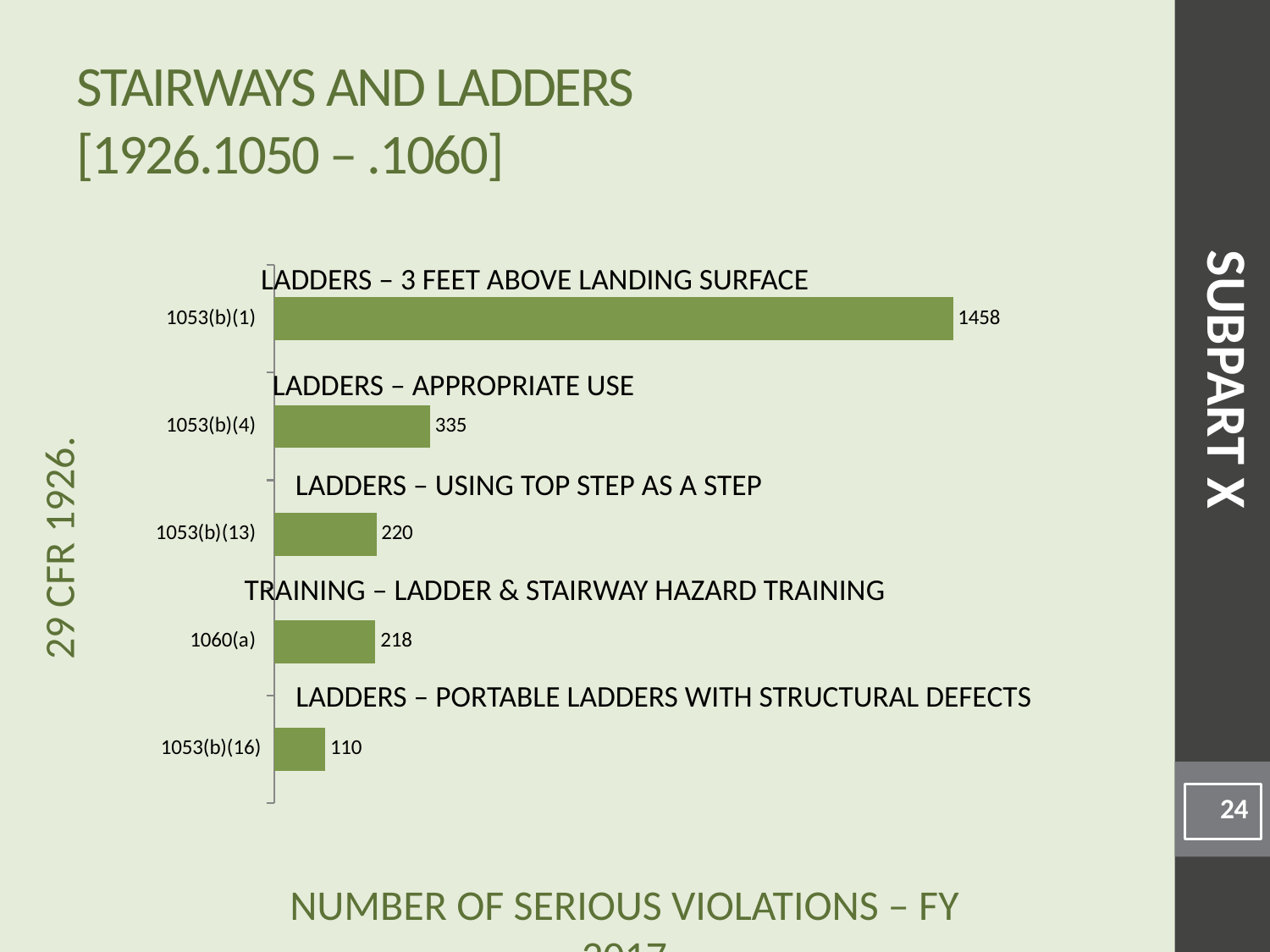
Which category has the lowest number of serious violations? 1053(b)(16) What kind of chart is shown on the slide? Bar chart What is the difference between the values for 1053(b)(1) and 1053(b)(4)? 1123 What is the number of serious violations for 1053(b)(4)? 335 What is the number of serious violations for 1060(a)? 218 Which category has the highest number of serious violations? 1053(b)(1) Which has more serious violations, 1053(b)(4) or 1053(b)(16)? 1053(b)(4) What is the number of serious violations for 1053(b)(13)? 220 What is the number of serious violations for 1053(b)(16)? 110 What is the difference between the values for 1053(b)(13) and 1060(a)? 2 How many categories are shown in the chart? 5 What is the number of serious violations for 1053(b)(1)? 1458